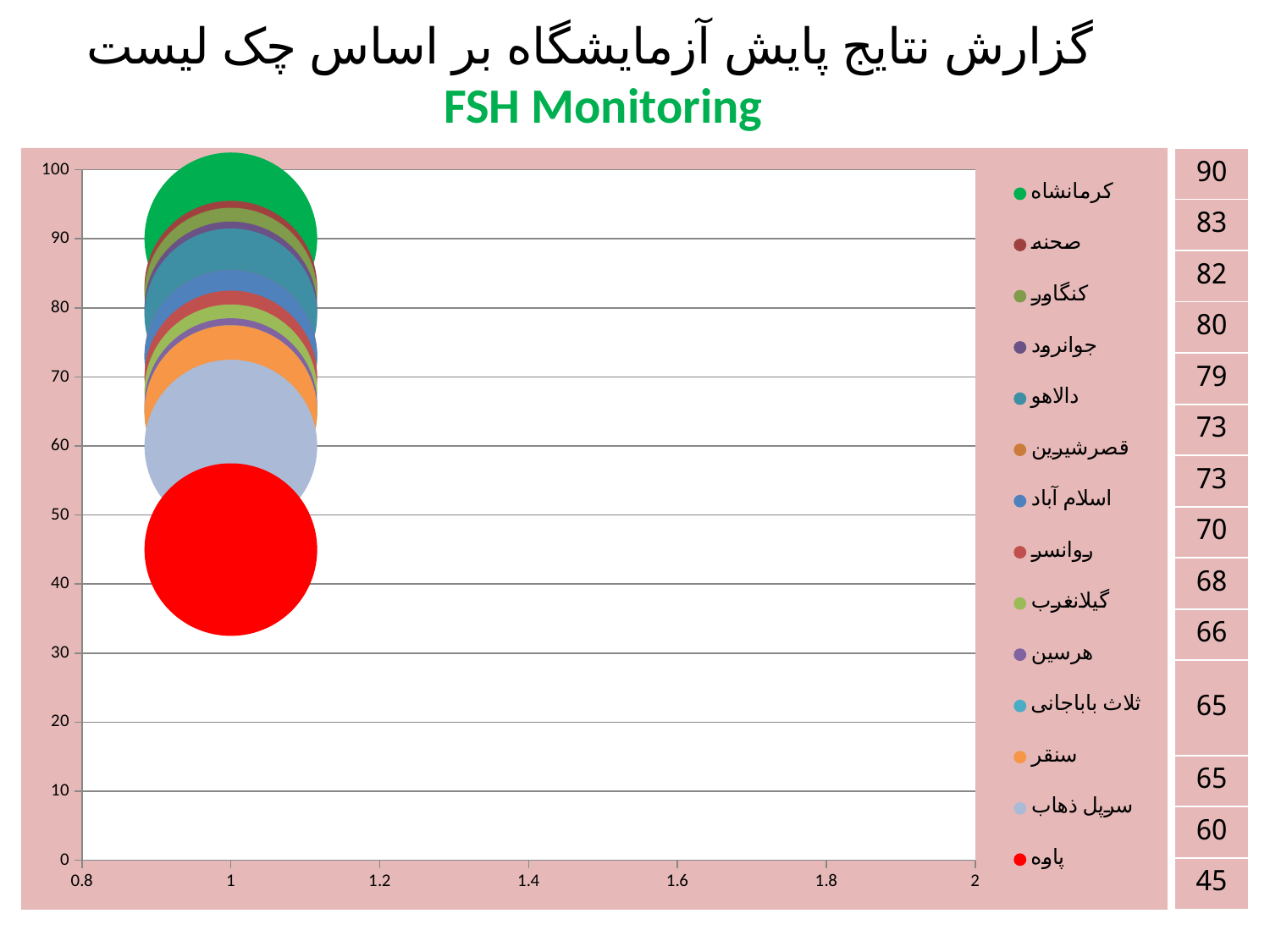
What is the value for پاوه shown in the table beside the chart? 45 How many series does the chart legend list? 14 Which is larger, the value for سرپل ذهاب or the value for پاوه? سرپل ذهاب Which series has the lowest value on the chart? پاوه What is the difference between the values for کرمانشاه and پاوه? 45 What is the value for کرمانشاه shown in the table beside the chart? 90 Is the value for پاوه greater or less than 50? less What is the value for سرپل ذهاب shown in the table beside the chart? 60 What is the English subtitle of the chart? FSH Monitoring What kind of chart is shown on the slide? bubble chart Which series has the highest value on the chart? کرمانشاه Is the value for کرمانشاه greater or less than 80? greater